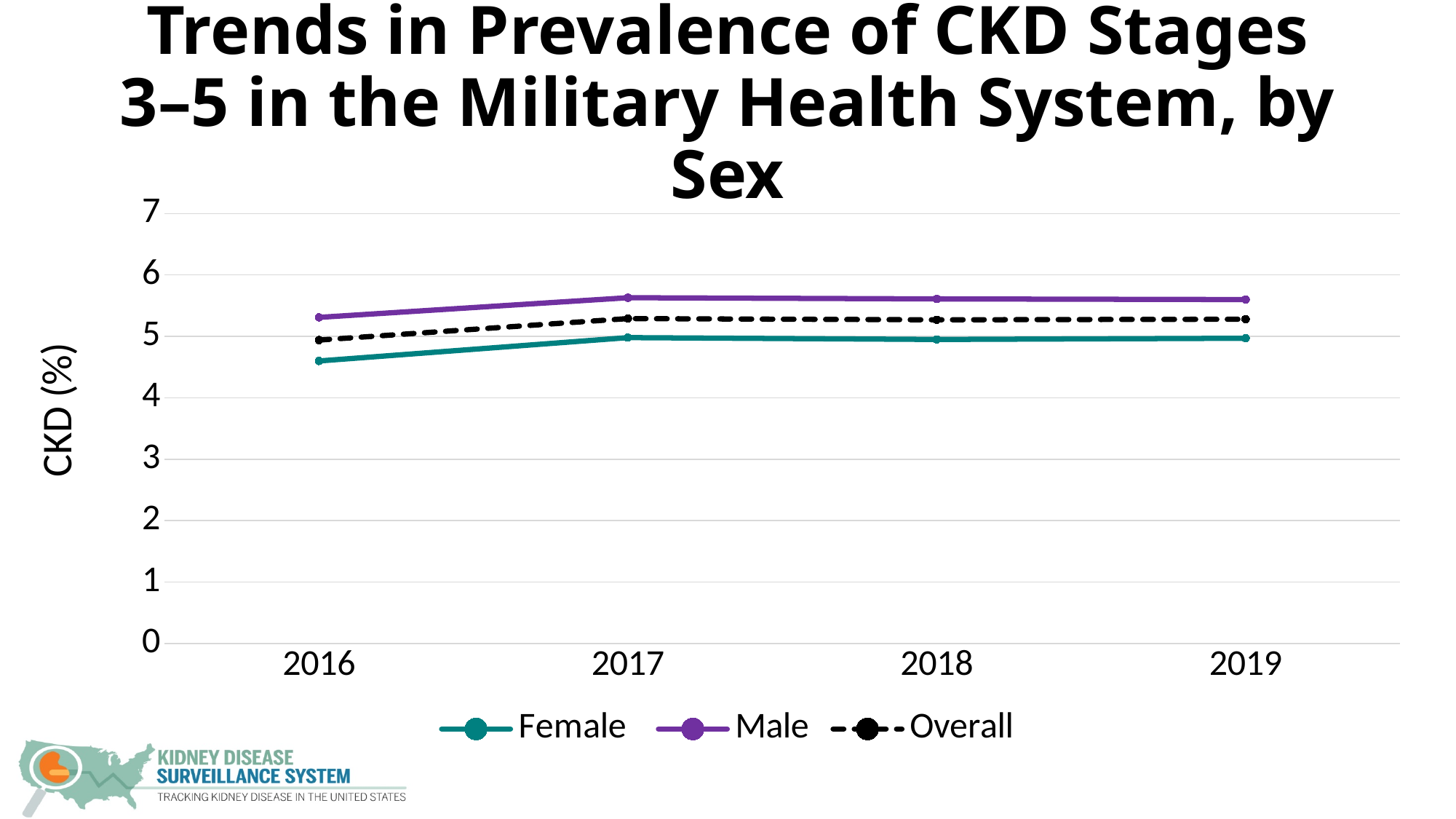
Is the Female value for 2016 greater or less than 5? less How many years are plotted along the x axis? 4 Is the Male value for 2019 greater or less than 6? less How many series does the legend list? 3 Which series has the highest value in 2019? Male What kind of chart is shown on the slide? line chart Which series has the lowest value in 2016? Female Does the Female line rise or fall from 2016 to 2017? rise What is the label on the y axis? CKD (%) Is the Male value for 2016 greater or less than 5? greater In 2016, which is larger, the Male value or the Female value? Male Which series is drawn with a dashed line? Overall